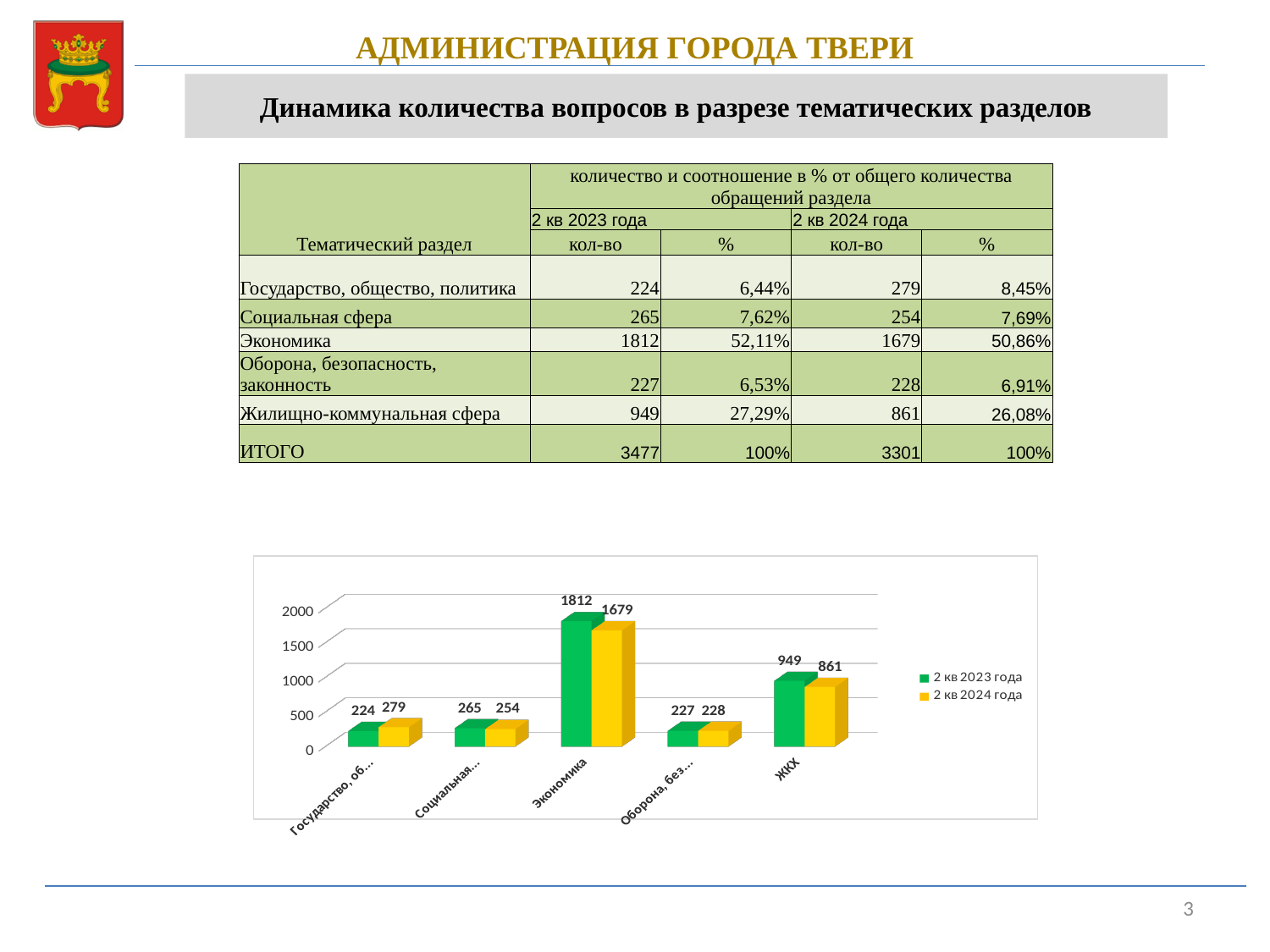
In the chart, which category has the highest value in the series 2 кв 2023 года? Экономика In the chart, what is the value for Экономика in the series 2 кв 2023 года? 1812 In the chart, what is the value for Экономика in the series 2 кв 2024 года? 1679 In the chart, what colour represents the series 2 кв 2024 года? yellow In the chart, which is larger for ЖКХ: the 2 кв 2023 года value or the 2 кв 2024 года value? 2 кв 2023 года In the chart, what is the difference between the 2 кв 2023 года and 2 кв 2024 года values for ЖКХ? 88 In the chart, is the value for Экономика in 2 кв 2024 года greater or less than 1500? greater In the chart, what is the value for ЖКХ in the series 2 кв 2024 года? 861 How many categories are shown on the x axis of the chart? 5 In the chart, what is the difference between the 2 кв 2023 года and 2 кв 2024 года values for Экономика? 133 What kind of chart is shown on the slide? bar chart How many series does the chart's legend list? 2